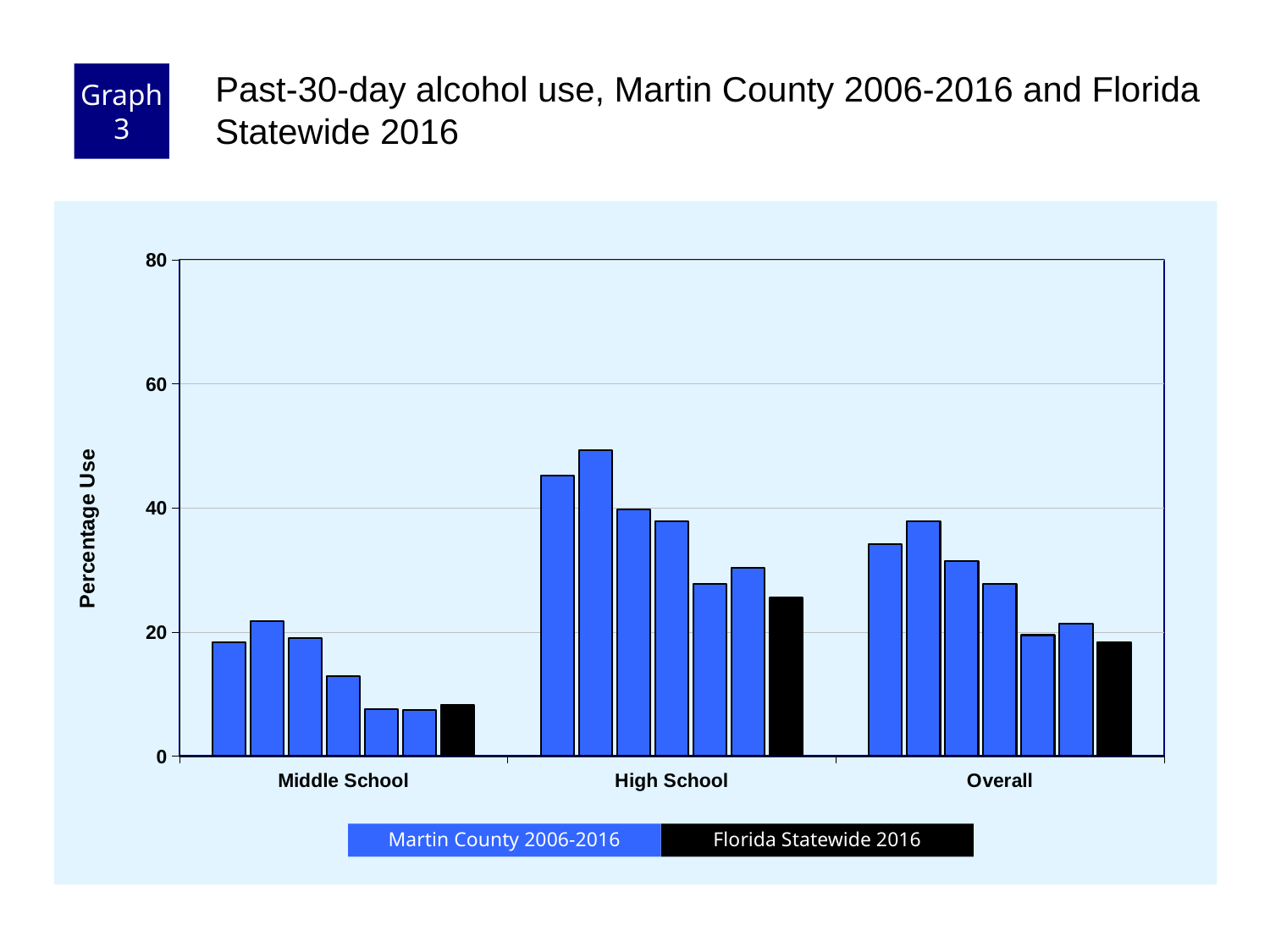
Is the Florida Statewide 2016 value for Middle School greater or less than 20? less Is the Florida Statewide 2016 value for High School greater or less than 20? greater How many school-level categories are shown on the x axis? 3 Is the tallest Martin County bar for High School greater or less than 40? greater Within the High School group, do the Martin County 2006-2016 bars generally rise or fall from left to right? fall What kind of chart is shown on the slide? bar chart Which category has the highest bars overall? High School Which category has the lowest bars overall? Middle School Which is larger for High School: the Florida Statewide 2016 bar or the tallest Martin County bar? the tallest Martin County bar How many series does the legend list? 2 What is the label on the y axis? Percentage Use